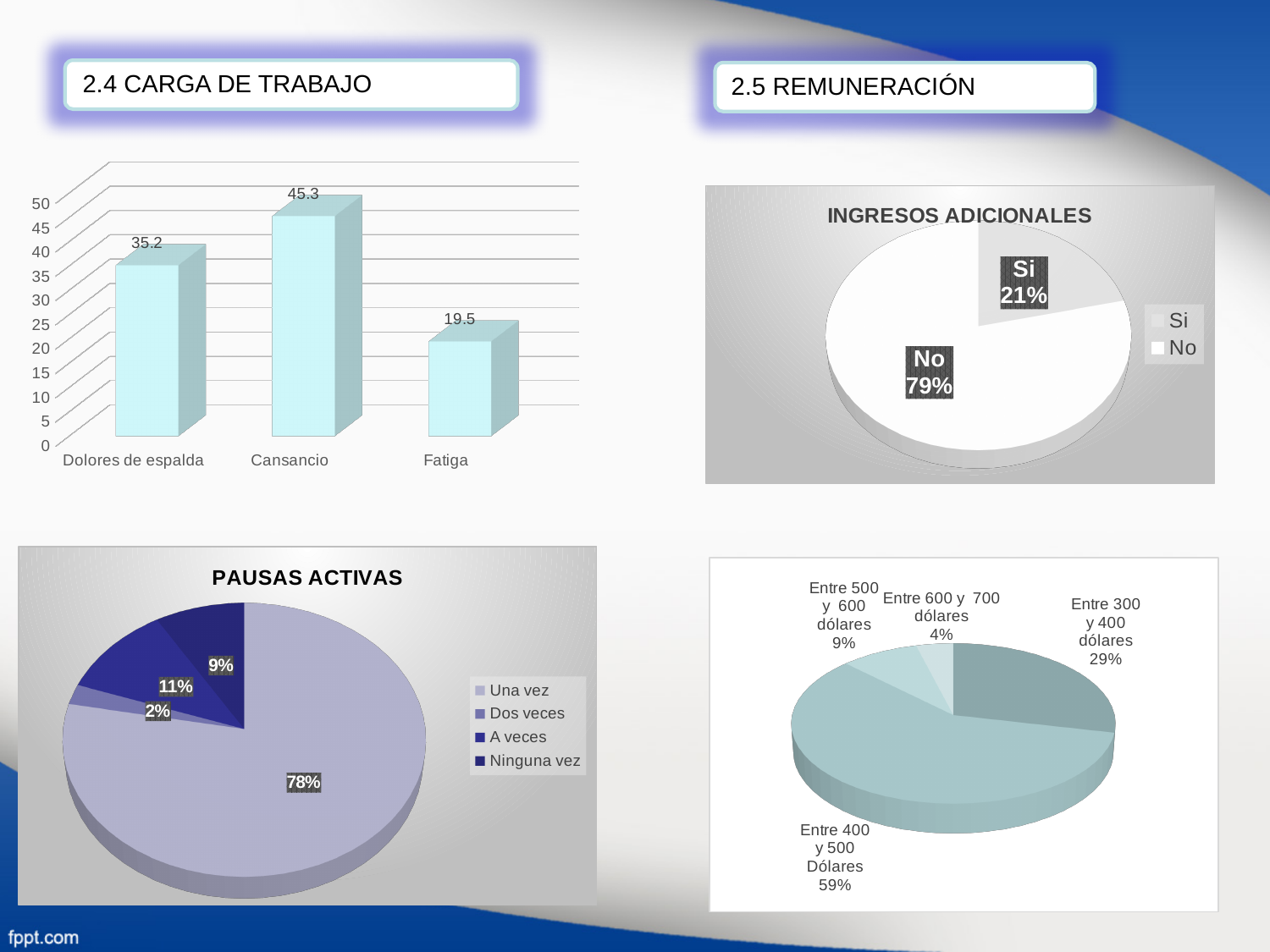
In the PAUSAS ACTIVAS pie chart, what share is labelled for the largest slice, Una vez? 78% In the top-left bar chart under 2.4 CARGA DE TRABAJO, what is the value for Dolores de espalda? 35.2 In the bottom-right pie chart, which slice is the smallest? Entre 600 y 700 dólares In the INGRESOS ADICIONALES pie chart, what share is labelled No? 79% How many entries does the legend of the PAUSAS ACTIVAS pie chart list? 4 In the top-left bar chart under 2.4 CARGA DE TRABAJO, what is the value for Cansancio? 45.3 In the top-left bar chart under 2.4 CARGA DE TRABAJO, what is the difference between the values for Cansancio and Fatiga? 25.8 What type of chart is the top-left chart under 2.4 CARGA DE TRABAJO? Bar chart In the top-left bar chart under 2.4 CARGA DE TRABAJO, how many categories are shown? 3 In the INGRESOS ADICIONALES pie chart, which slice is larger, Si or No? No In the bottom-right pie chart, what share is labelled for Entre 400 y 500 Dólares? 59% In the top-left bar chart under 2.4 CARGA DE TRABAJO, which category has the lowest value? Fatiga